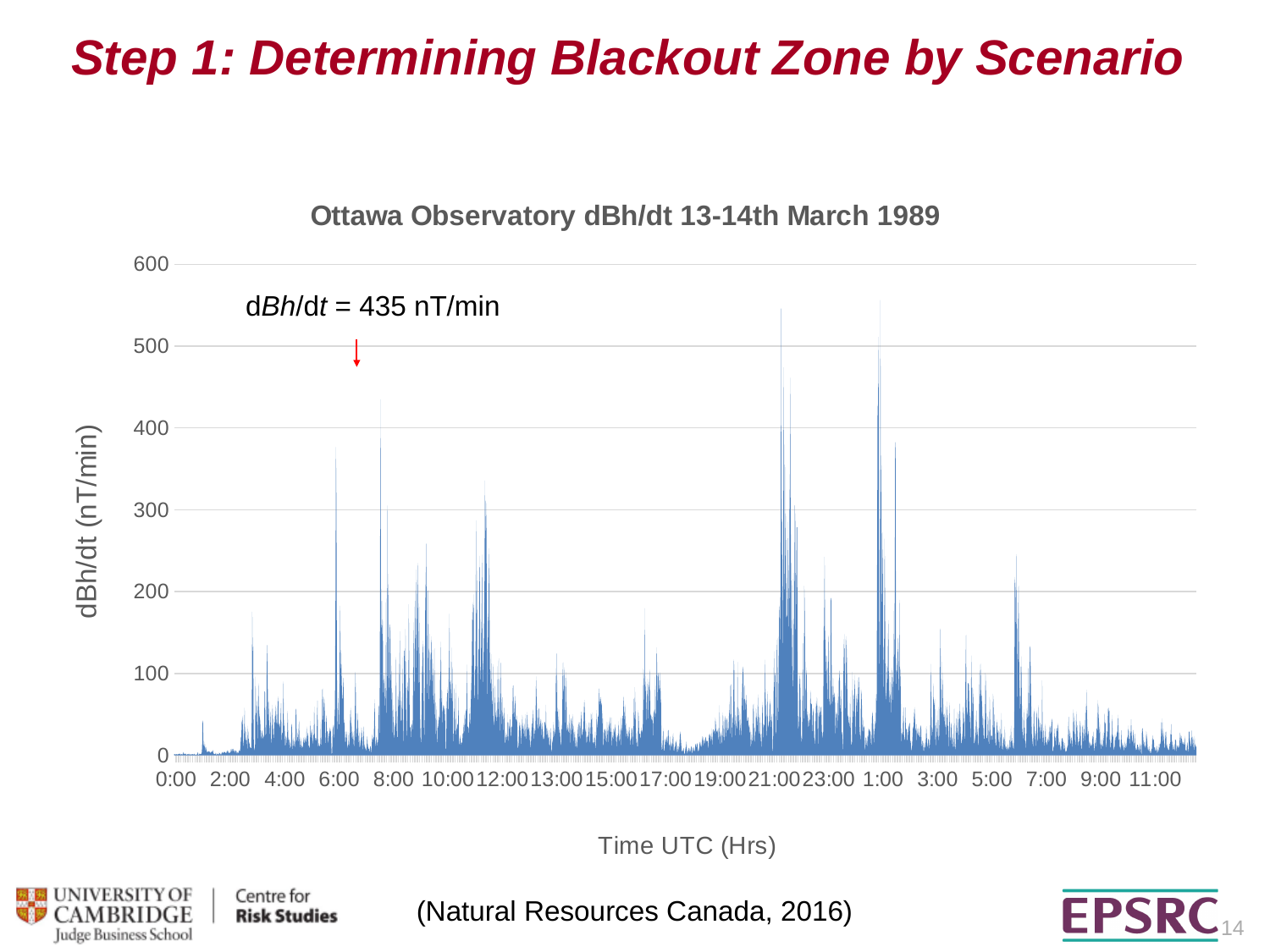
Is the peak near 11:30 on the chart greater or less than 200 nT/min? greater What is the highest value shown on the y axis of the chart? 600 What is the title of the chart? Ottawa Observatory dBh/dt 13-14th March 1989 What is the label of the y axis of the chart? dBh/dt (nT/min) Which peak is higher on the chart: the one near 21:30 or the one near 6:00? the one near 21:30 Is the tallest peak on the chart, near 21:00-22:00, greater or less than 500 nT/min? greater Which peak is higher on the chart: the one near 21:30 or the one near 1:00? the one near 21:30 Is the peak near 1:00 on the chart greater or less than 400 nT/min? greater What value of dBh/dt is called out by the annotation on the chart? 435 nT/min